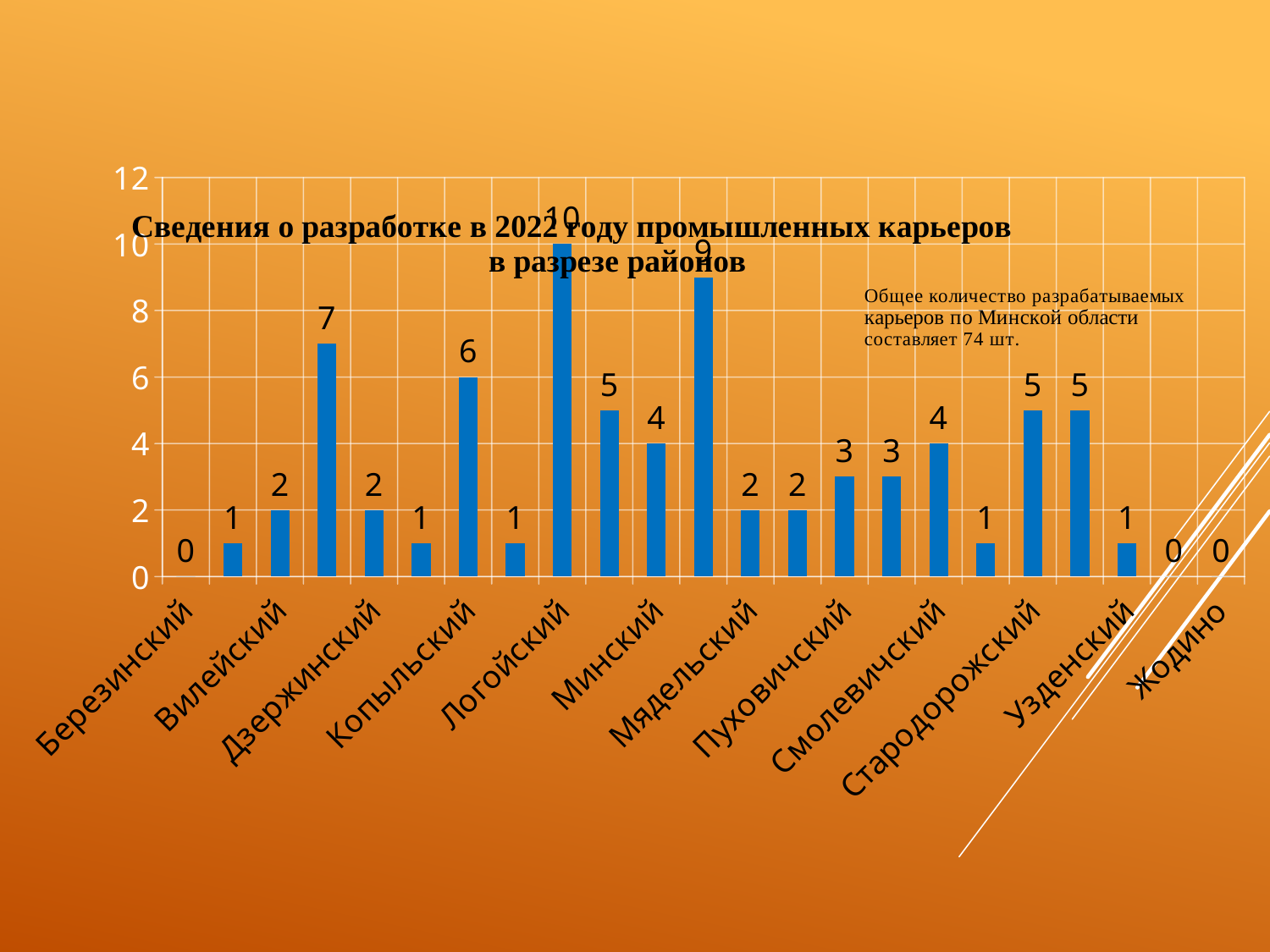
How many bars (districts) are plotted in the chart? 23 What is the value for Березинский? 0 What is the highest value shown in the chart? 10 What type of chart is shown on the slide? bar chart What is the value for Логойский? 10 What is the value for Копыльский? 6 Which has a larger value, Логойский or Стародорожский? Логойский What is the value for Жодино? 0 What is the value for Стародорожский? 5 What is the maximum value shown on the vertical axis? 12 According to the text on the slide, what is the total number of quarries being developed in the Minsk region? 74 шт. What is the difference between the value for Логойский and the value for Копыльский? 4